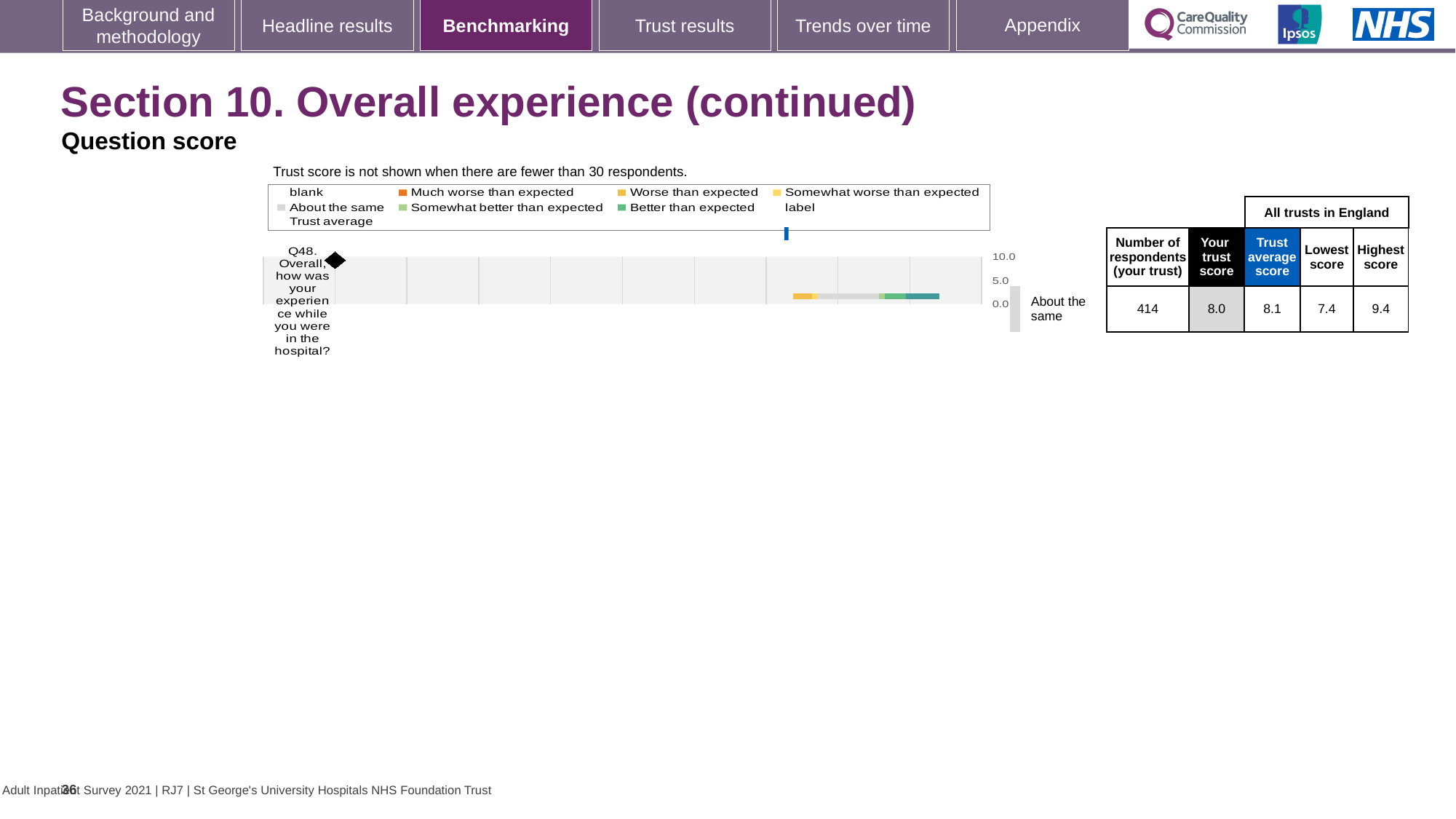
How many questions are plotted on the chart? 1 Which is larger for Q48: your trust score or the trust average score? Trust average score What is the trust average score for Q48 across all trusts in England? 8.1 What is the difference between the highest score and the lowest score for Q48? 2.0 What is the trust score for Q48 shown next to the chart? 8.0 What is the lowest score for Q48 across all trusts in England? 7.4 What kind of chart is used to show the Q48 question score? bar chart Which question is plotted on the chart? Q48. Overall, how was your experience while you were in the hospital? Which benchmark category is the trust's Q48 score placed in? About the same What is the highest score for Q48 across all trusts in England? 9.4 How many respondents from the trust answered Q48? 414 What is the difference between the trust average score and your trust score for Q48? 0.1